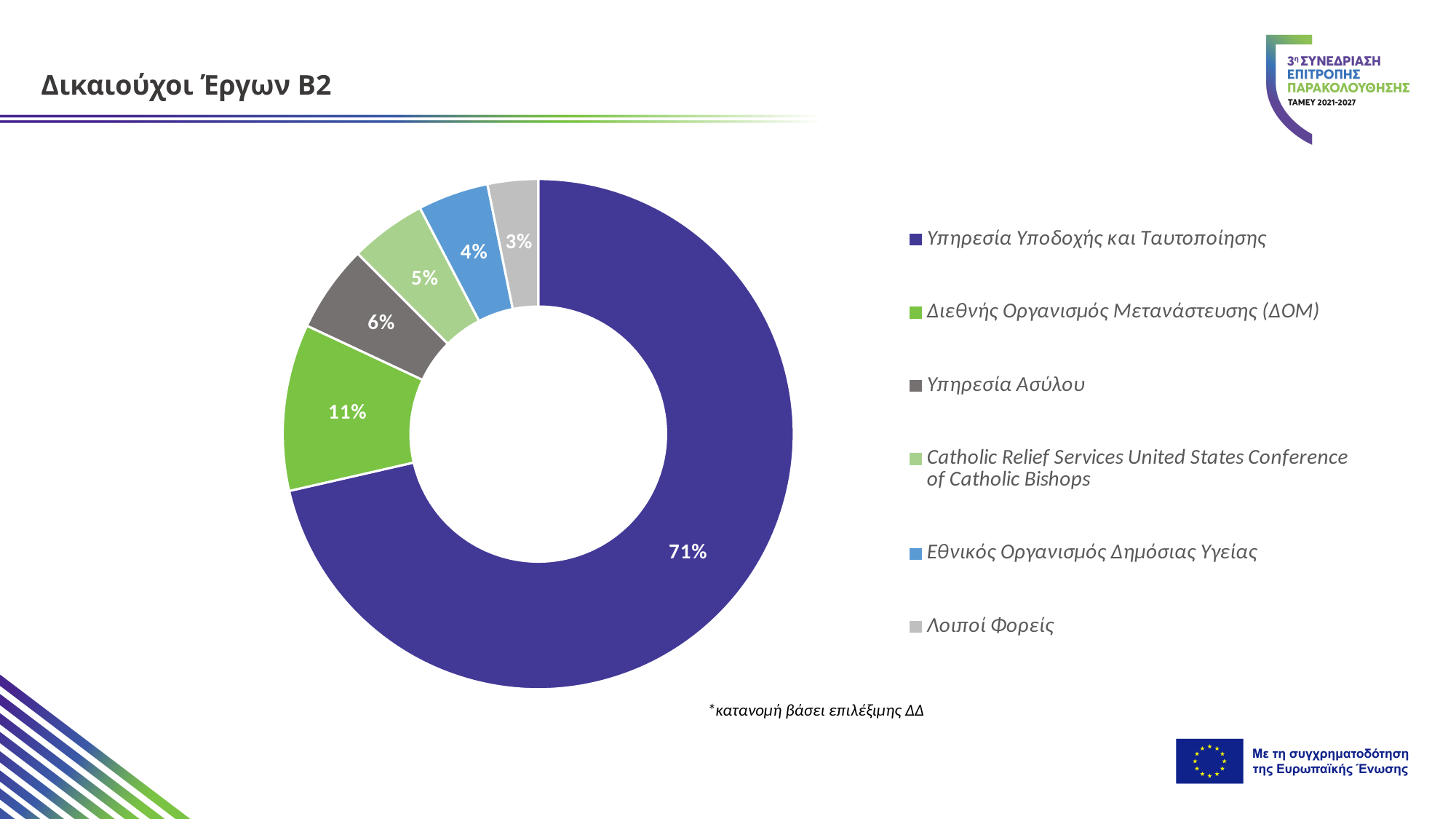
What kind of chart is shown on the slide? Doughnut (pie) chart What share of the chart does Διεθνής Οργανισμός Μετανάστευσης (ΔΟΜ) hold? 11% What is the difference in percentage points between Υπηρεσία Υποδοχής και Ταυτοποίησης and Διεθνής Οργανισμός Μετανάστευσης (ΔΟΜ)? 60 percentage points How many categories are shown in the chart? 6 What share of the chart does Εθνικός Οργανισμός Δημόσιας Υγείας hold? 4% Which category has the largest slice? Υπηρεσία Υποδοχής και Ταυτοποίησης Which category has the smallest slice? Λοιποί Φορείς What share of the chart does Υπηρεσία Ασύλου hold? 6% What share of the chart does Υπηρεσία Υποδοχής και Ταυτοποίησης hold? 71% What share of the chart does Λοιποί Φορείς hold? 3% What share of the chart does Catholic Relief Services United States Conference of Catholic Bishops hold? 5% Which is larger, the slice for Υπηρεσία Ασύλου or the slice for Εθνικός Οργανισμός Δημόσιας Υγείας? Υπηρεσία Ασύλου